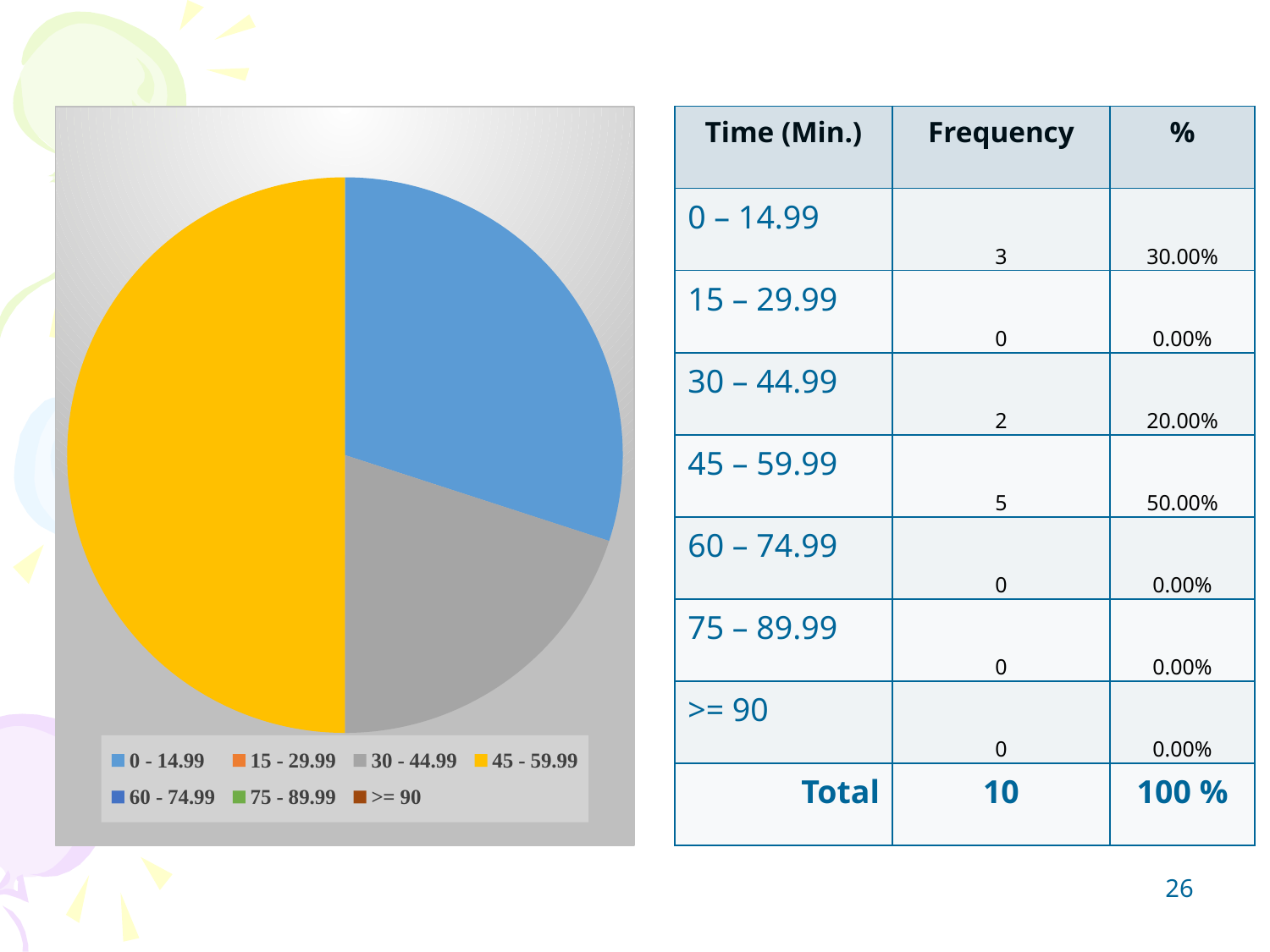
How many slices are visible in the pie chart? 3 What is the total frequency across all categories? 10 Which category has the largest slice in the pie chart? 45 - 59.99 What share of the pie does the 30 - 44.99 slice represent? 20.00% What share of the pie does the 45 - 59.99 slice represent? 50.00% What is the frequency for the 45 - 59.99 category? 5 Which slice is larger in the pie chart, 0 - 14.99 or 30 - 44.99? 0 - 14.99 What share of the pie does the 0 - 14.99 slice represent? 30.00% What kind of chart is shown on the slide? pie chart What colour is the 45 - 59.99 slice in the pie chart? yellow What colour is the 0 - 14.99 slice in the pie chart? blue How many entries does the pie chart's legend list? 7